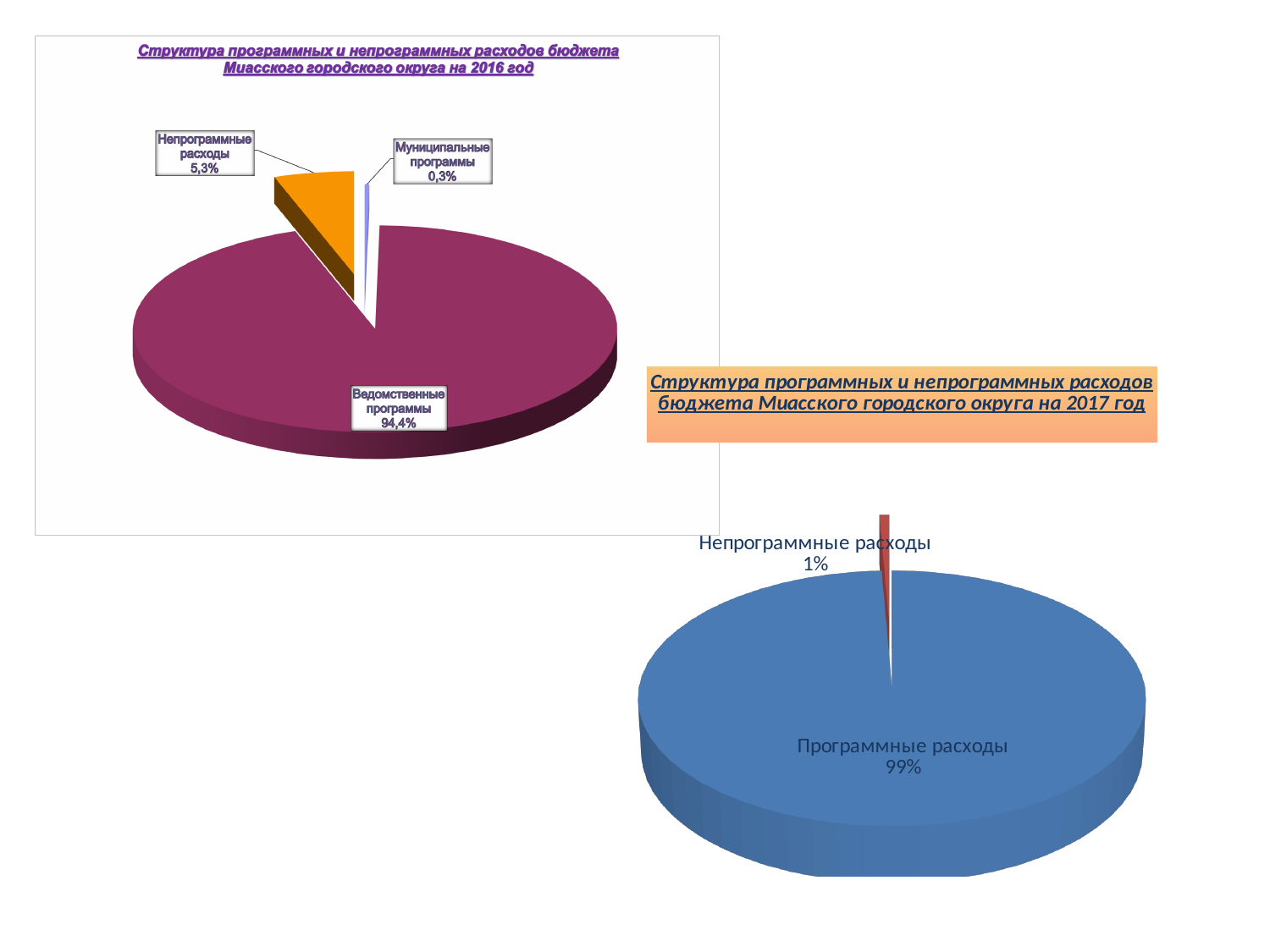
What type of chart is the 2017 chart (bottom right)? Pie chart Which is larger: "Непрограммные расходы" in the 2016 chart or "Непрограммные расходы" in the 2017 chart? 2016 (5,3%) In the 2016 chart (top left), what share is shown for "Непрограммные расходы"? 5,3% How many slices does the 2016 chart (top left) have? 3 In the 2017 chart (bottom right), what share is shown for "Непрограммные расходы"? 1% In the 2016 chart (top left), what share is shown for "Ведомственные программы"? 94,4% How many slices does the 2017 chart (bottom right) have? 2 In the 2016 chart (top left), which category has the largest share? Ведомственные программы In the 2016 chart (top left), what share is shown for "Муниципальные программы"? 0,3% In the 2016 chart (top left), what is the difference in percentage points between "Непрограммные расходы" and "Муниципальные программы"? 5,0 percentage points In the 2017 chart (bottom right), what share is shown for "Программные расходы"? 99% In the 2016 chart (top left), which category has the smallest share? Муниципальные программы